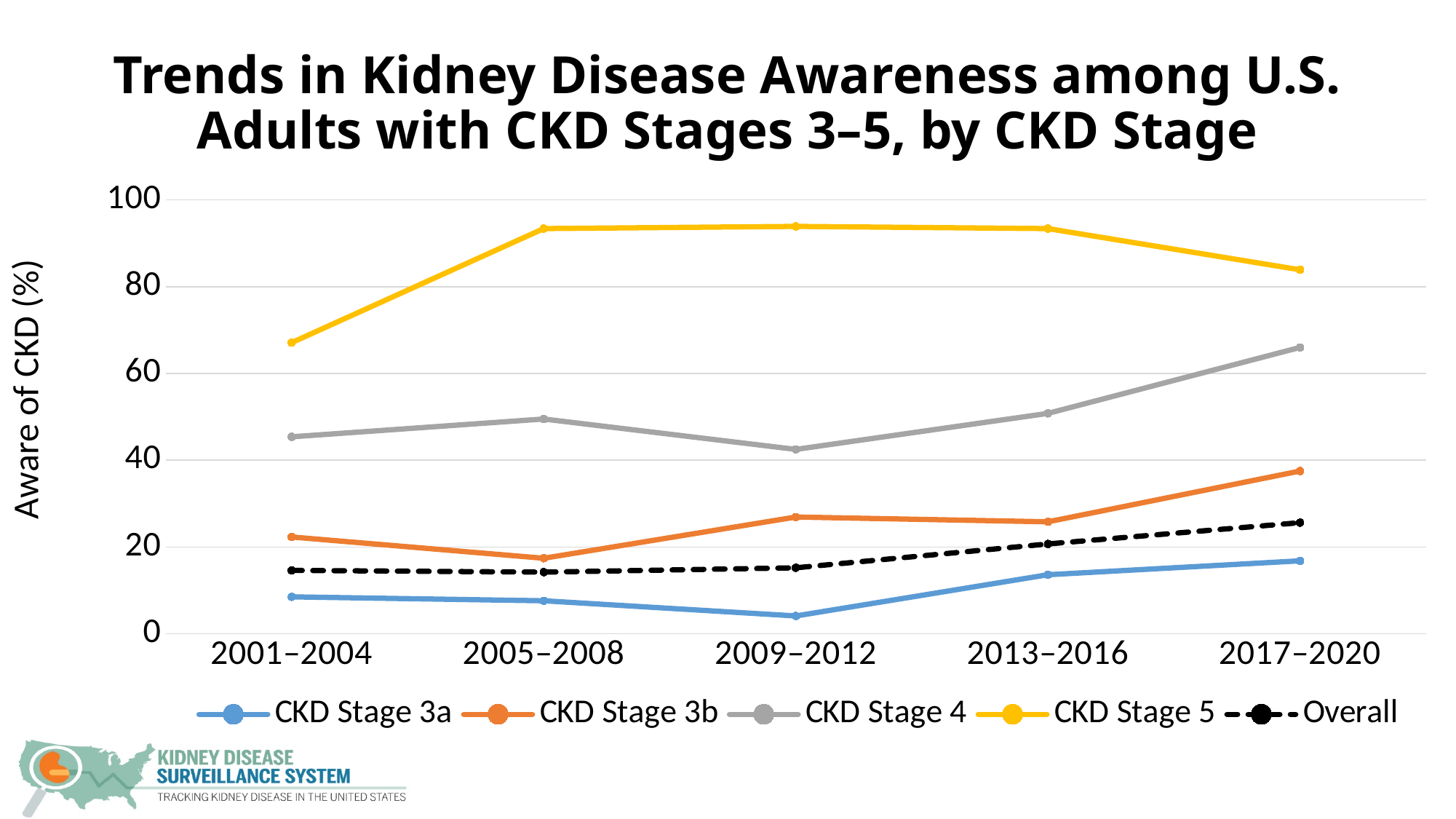
Does the CKD Stage 5 line rise or fall from 2013–2016 to 2017–2020? fall Which CKD stage series has the highest awareness in 2017–2020? CKD Stage 5 How many time periods are shown on the x axis? 5 In 2001–2004, which is larger: the value for CKD Stage 4 or CKD Stage 3b? CKD Stage 4 Which series is drawn with a dashed line? Overall What kind of chart is shown on the slide? line chart Is the value for CKD Stage 4 in 2017–2020 greater or less than 60? greater How many series does the legend list? 5 Does the CKD Stage 3a line rise or fall from 2009–2012 to 2017–2020? rise Is the value for CKD Stage 5 in 2005–2008 greater or less than 80? greater Which series has the lowest awareness in 2009–2012? CKD Stage 3a Is the value for CKD Stage 3a in 2009–2012 greater or less than 20? less